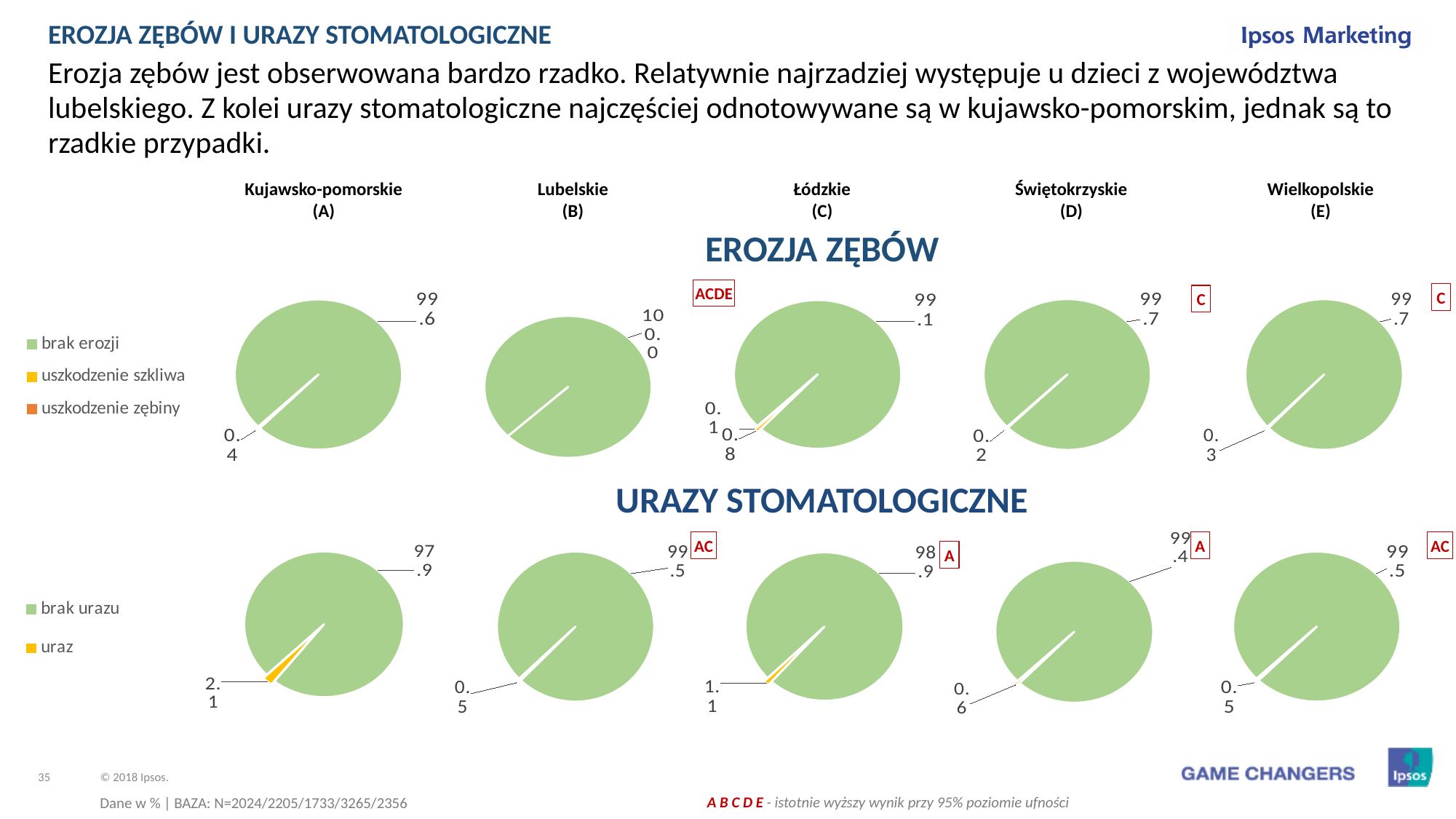
What kind of chart is used on this slide? Pie chart In the EROZJA ZĘBÓW pie chart for Łódzkie (C), what is the value for uszkodzenie zębiny? 0.1 In the EROZJA ZĘBÓW pie chart for Lubelskie (B), what is the value for brak erozji? 100.0 In the URAZY STOMATOLOGICZNE pie chart for Kujawsko-pomorskie (A), what is the value for uraz? 2.1 How many pie charts are shown in the URAZY STOMATOLOGICZNE row? 5 In the URAZY STOMATOLOGICZNE pie chart for Łódzkie (C), what is the value for brak urazu? 98.9 Across the URAZY STOMATOLOGICZNE pie charts, which region has the highest value for uraz? Kujawsko-pomorskie (A) Across the EROZJA ZĘBÓW pie charts, which region has the highest value for brak erozji? Lubelskie (B) How many series does the legend for the EROZJA ZĘBÓW charts list? 3 In the URAZY STOMATOLOGICZNE charts, what is the difference between the uraz value for Kujawsko-pomorskie (A) and for Łódzkie (C)? 1.0 In the URAZY STOMATOLOGICZNE charts, which is larger: the uraz value for Świętokrzyskie (D) or for Wielkopolskie (E)? Świętokrzyskie (D) In the EROZJA ZĘBÓW pie chart for Kujawsko-pomorskie (A), what is the value for brak erozji? 99.6